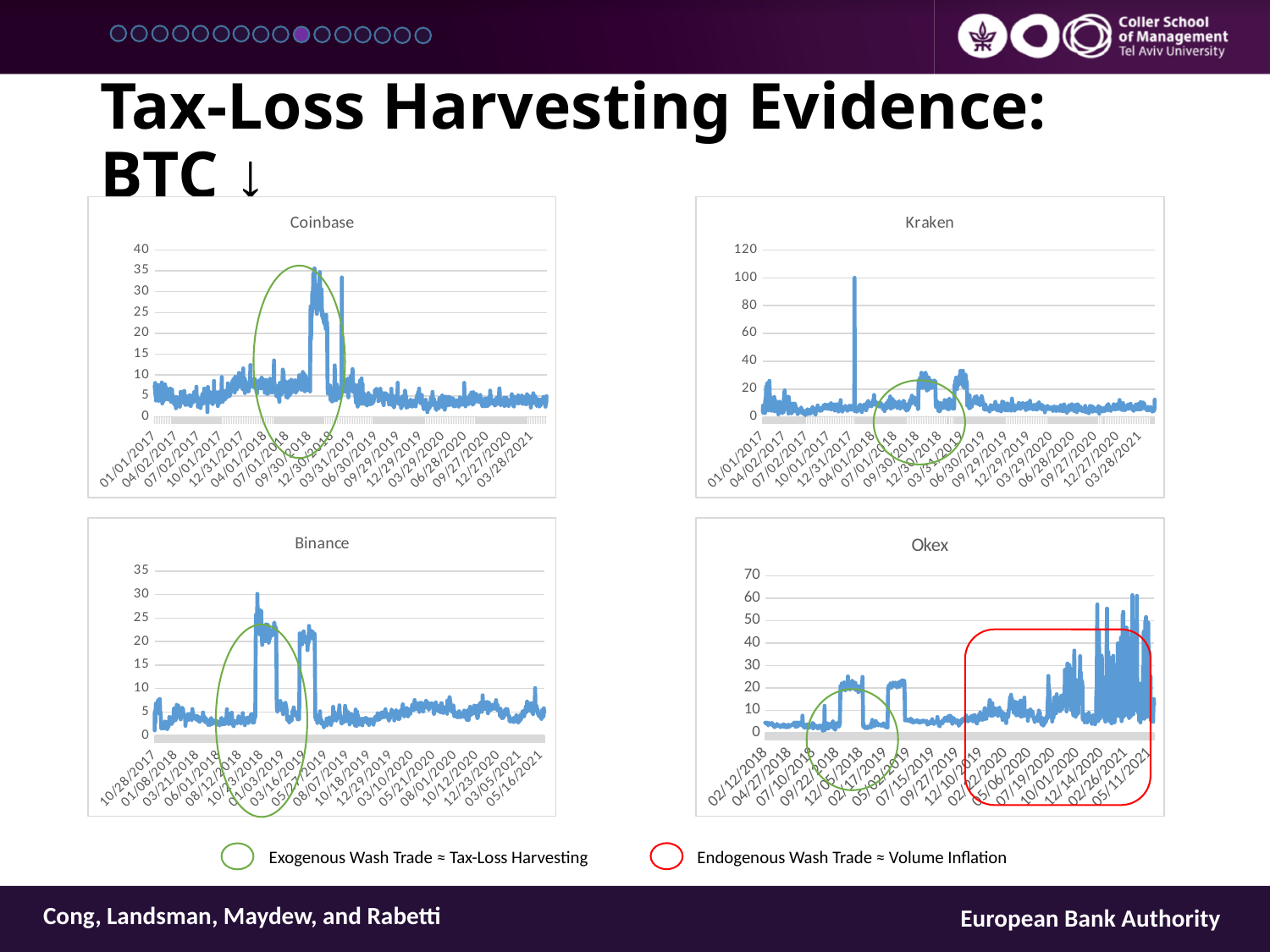
In the Coinbase chart, is the highest peak greater or less than 30? greater In the Okex chart, is the highest peak greater or less than 50? greater In the Coinbase chart, are the values during 2020 greater or less than 10? less Which chart has the higher peak value, Okex or Binance? Okex What kind of chart is the Coinbase chart? line chart According to the legend at the bottom of the slide, what does the green circle indicate? Exogenous Wash Trade ≈ Tax-Loss Harvesting Which chart has the higher peak value, Kraken or Coinbase? Kraken Which of the four charts has the largest maximum value on its y axis? Kraken How many charts are shown on the slide? 4